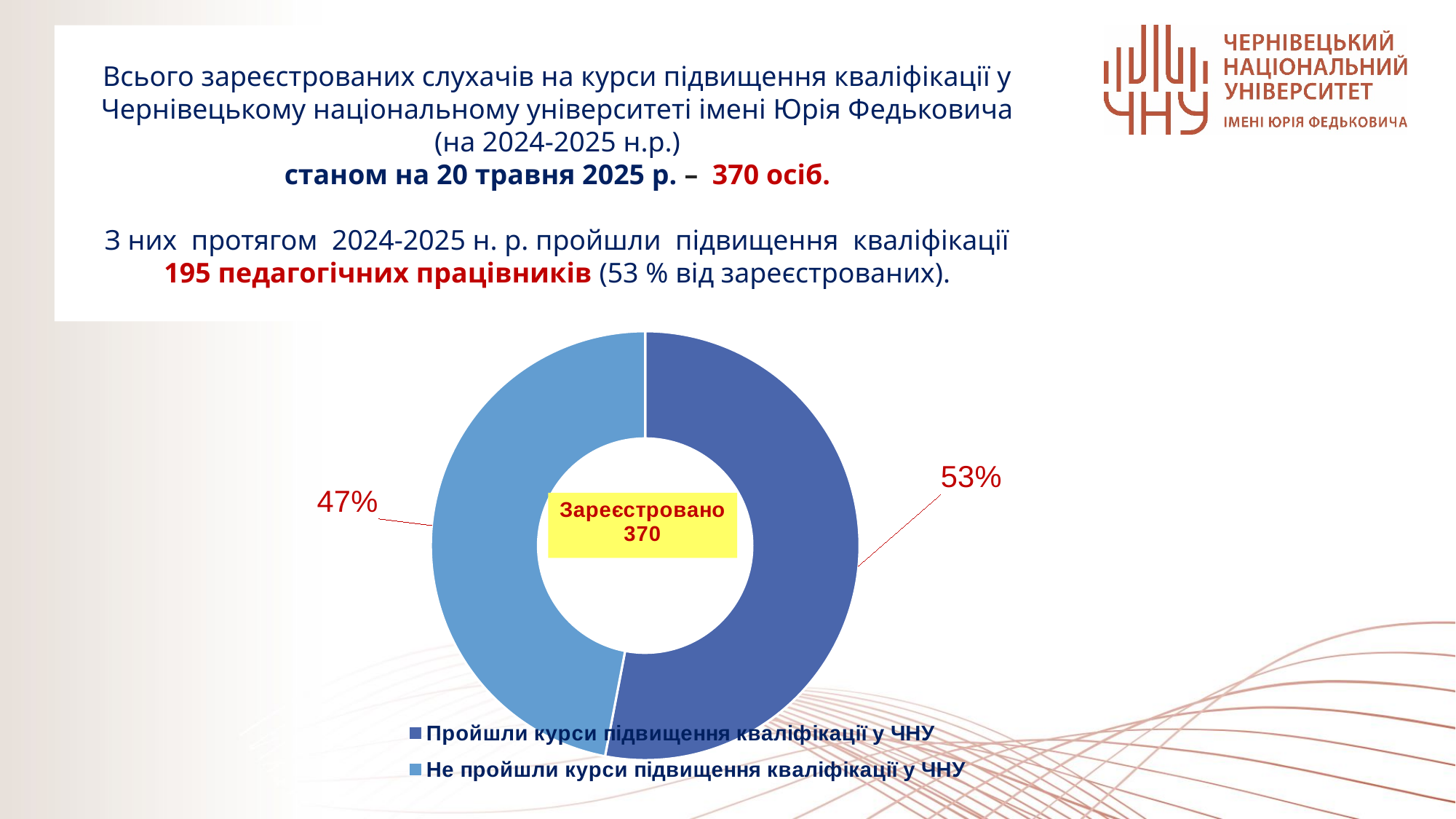
What is the difference in percentage points between the "Пройшли" slice and the "Не пройшли" slice? 6 percentage points Which slice of the chart is the largest? Пройшли курси підвищення кваліфікації у ЧНУ What number is shown in the centre of the chart? 370 What share of the chart is labelled "Не пройшли курси підвищення кваліфікації у ЧНУ"? 47% Which is larger: the share of those who completed the courses ("Пройшли") or those who did not ("Не пройшли")? Пройшли курси підвищення кваліфікації у ЧНУ Which colour represents "Не пройшли курси підвищення кваліфікації у ЧНУ" in the chart? Light blue Which slice of the chart is the smallest? Не пройшли курси підвищення кваліфікації у ЧНУ Is the share of "Пройшли курси підвищення кваліфікації у ЧНУ" greater or less than 50%? greater What kind of chart is shown on the slide? Doughnut chart What share of the chart is labelled "Пройшли курси підвищення кваліфікації у ЧНУ"? 53% How many slices does the chart have? 2 How many entries does the chart legend list? 2